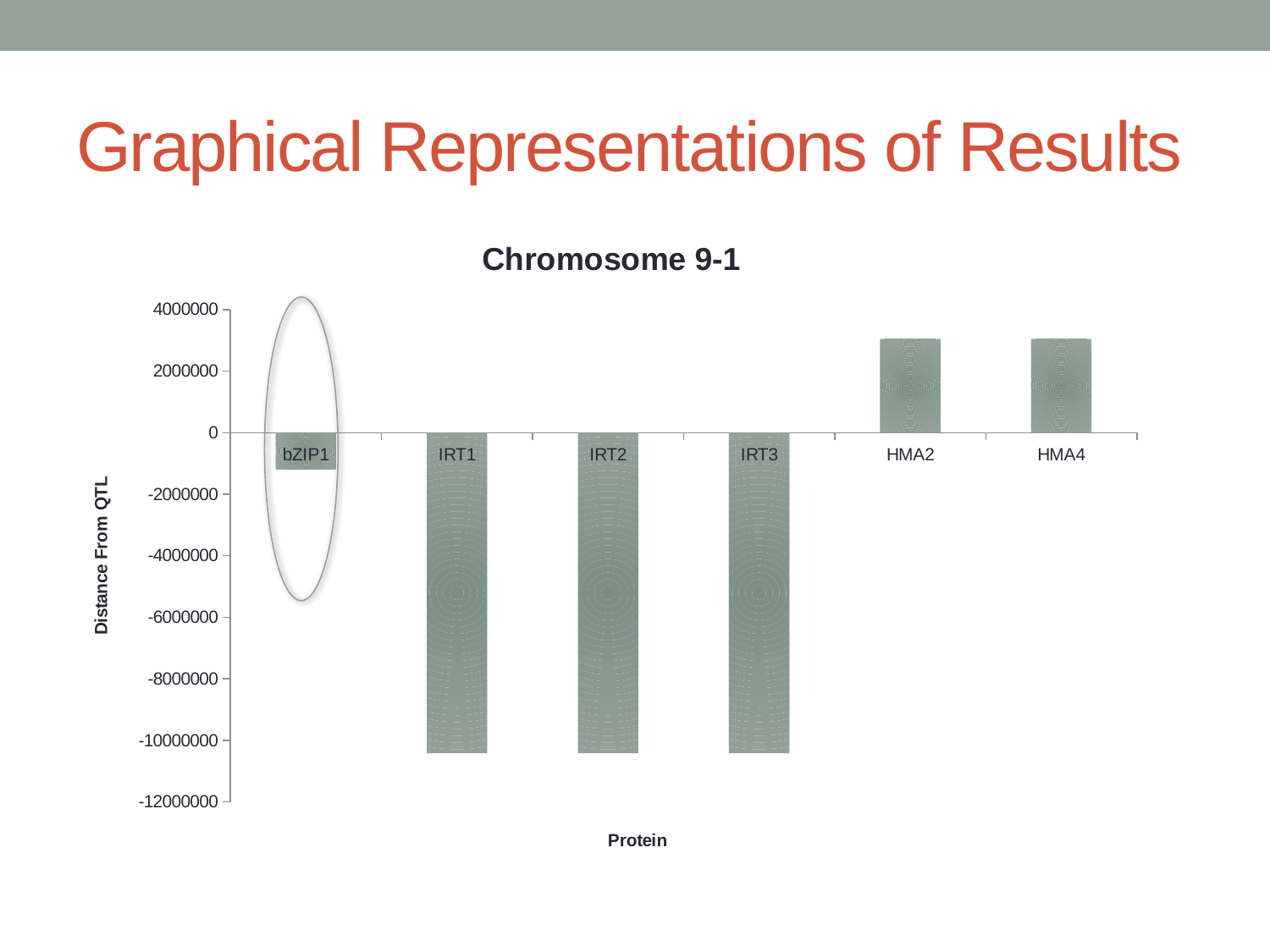
Is the value for bZIP1 greater or less than -2000000? greater What kind of chart is shown on the slide? bar chart Which has the larger value, HMA2 or IRT2? HMA2 How many proteins are plotted on the x axis of the chart? 6 How many bars in the chart have negative values? 4 What is the label of the y axis of the chart? Distance From QTL What is the title of the chart? Chromosome 9-1 Is the value for IRT1 greater or less than -10000000? less Which has the larger value, bZIP1 or IRT1? bZIP1 Is the value for IRT3 greater or less than -8000000? less